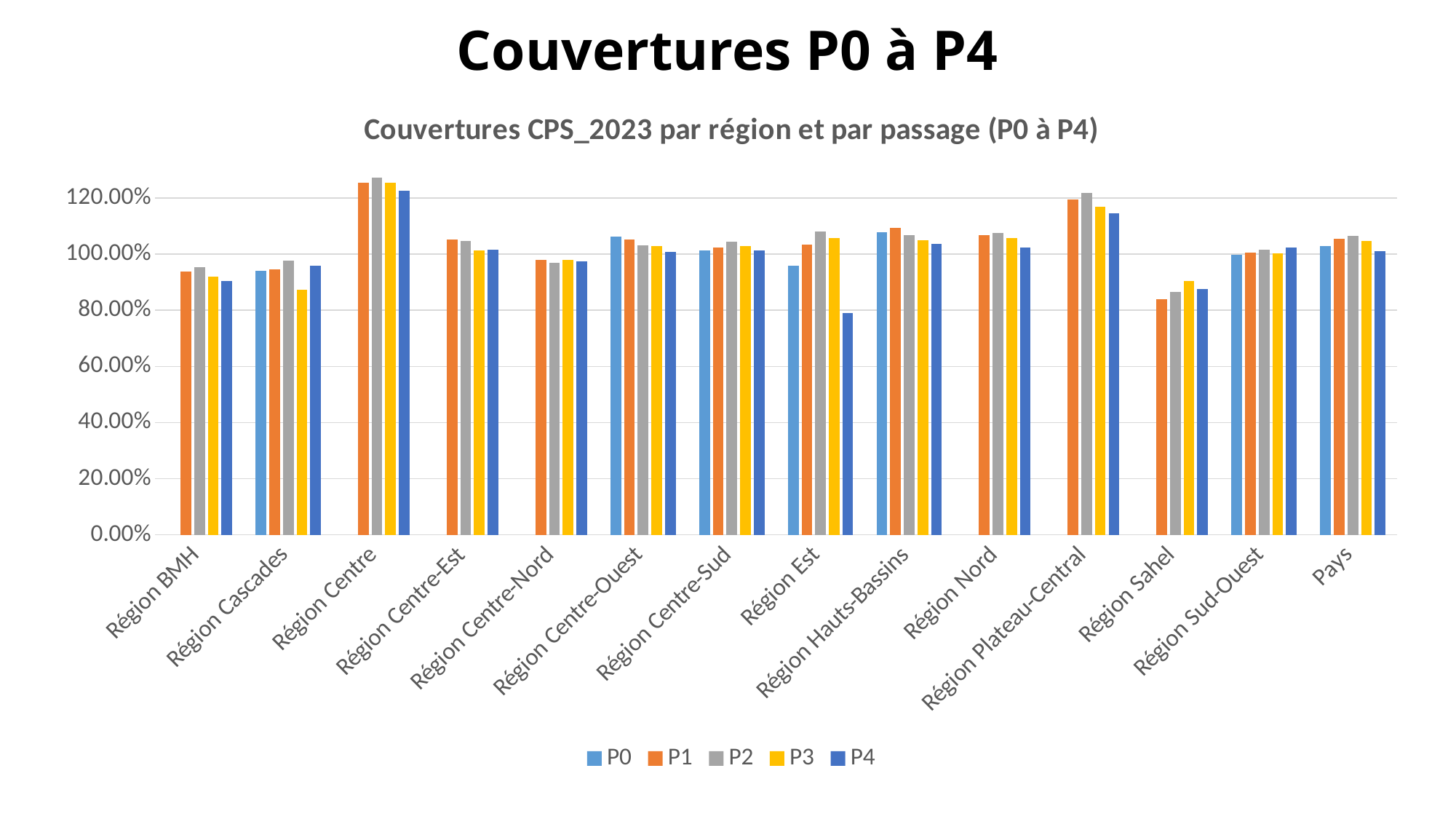
What kind of chart is shown on the slide? bar chart How many series does the legend list? 5 Which is larger: the P2 value for Région Centre or the P2 value for Région Sahel? Région Centre Is the P2 value for Région Centre greater or less than 120.00%? greater Which region has the highest coverage values across all passages? Région Centre Is the P1 value for Région Plateau-Central greater or less than 100.00%? greater Is the P1 value for Région Sahel greater or less than 100.00%? less Which is larger for Région Est: the P2 value or the P4 value? P2 What is the title of the chart? Couvertures CPS_2023 par région et par passage (P0 à P4) How many categories are shown on the x axis? 14 What colour are the P3 bars? yellow